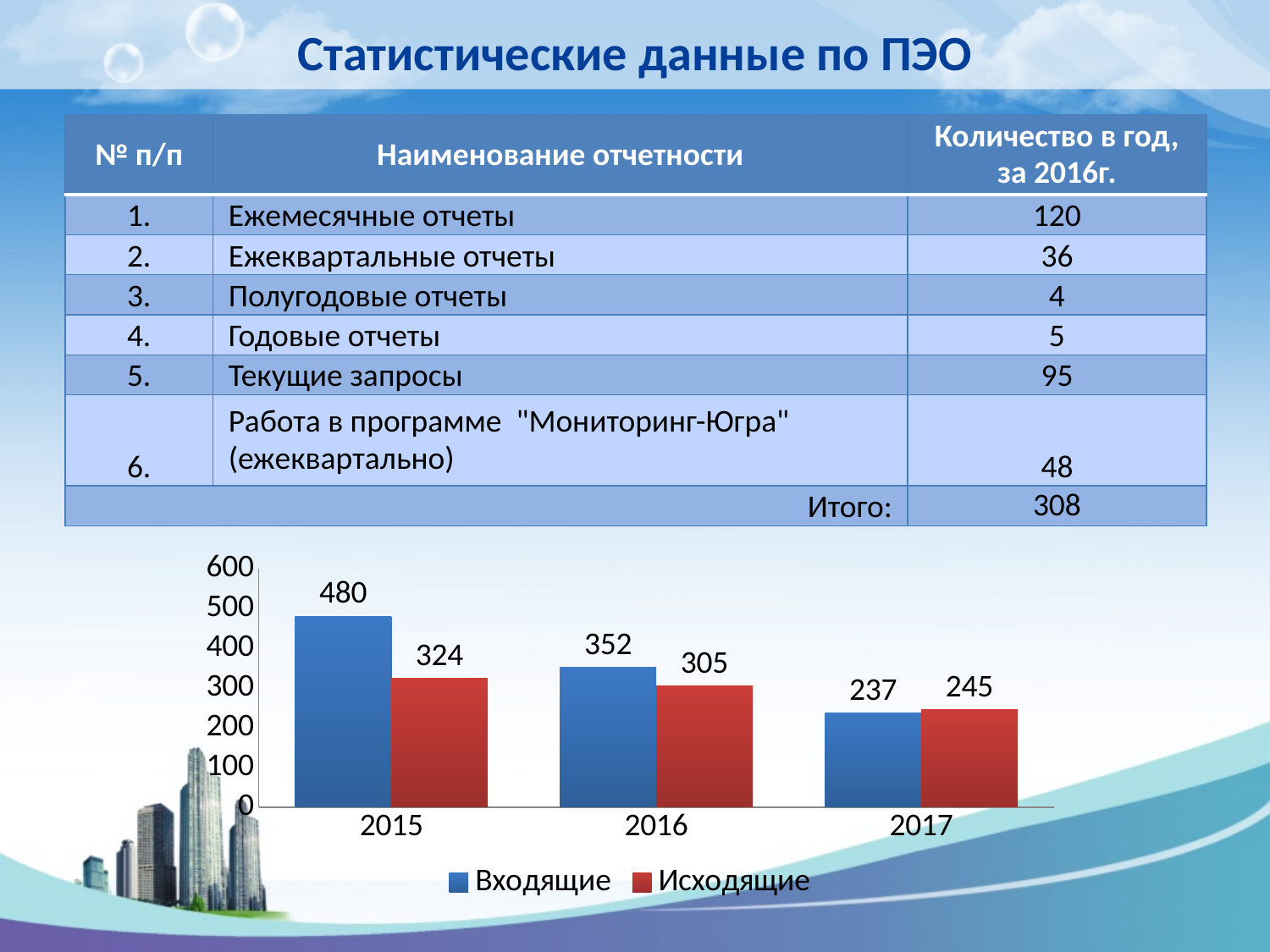
Do the Входящие values rise or fall from 2015 to 2017? fall Which is larger in 2017, Входящие or Исходящие? Исходящие What kind of chart is shown on the slide? bar chart How many years are shown on the x axis of the chart? 3 In which year is the Входящие value highest? 2015 In which year is the Исходящие value lowest? 2017 What is the value for Исходящие in 2017? 245 How many series does the chart legend list? 2 What is the difference between the Входящие values for 2015 and 2016? 128 What is the value for Входящие in 2015? 480 What is the difference between Входящие and Исходящие in 2015? 156 What is the value for Исходящие in 2016? 305